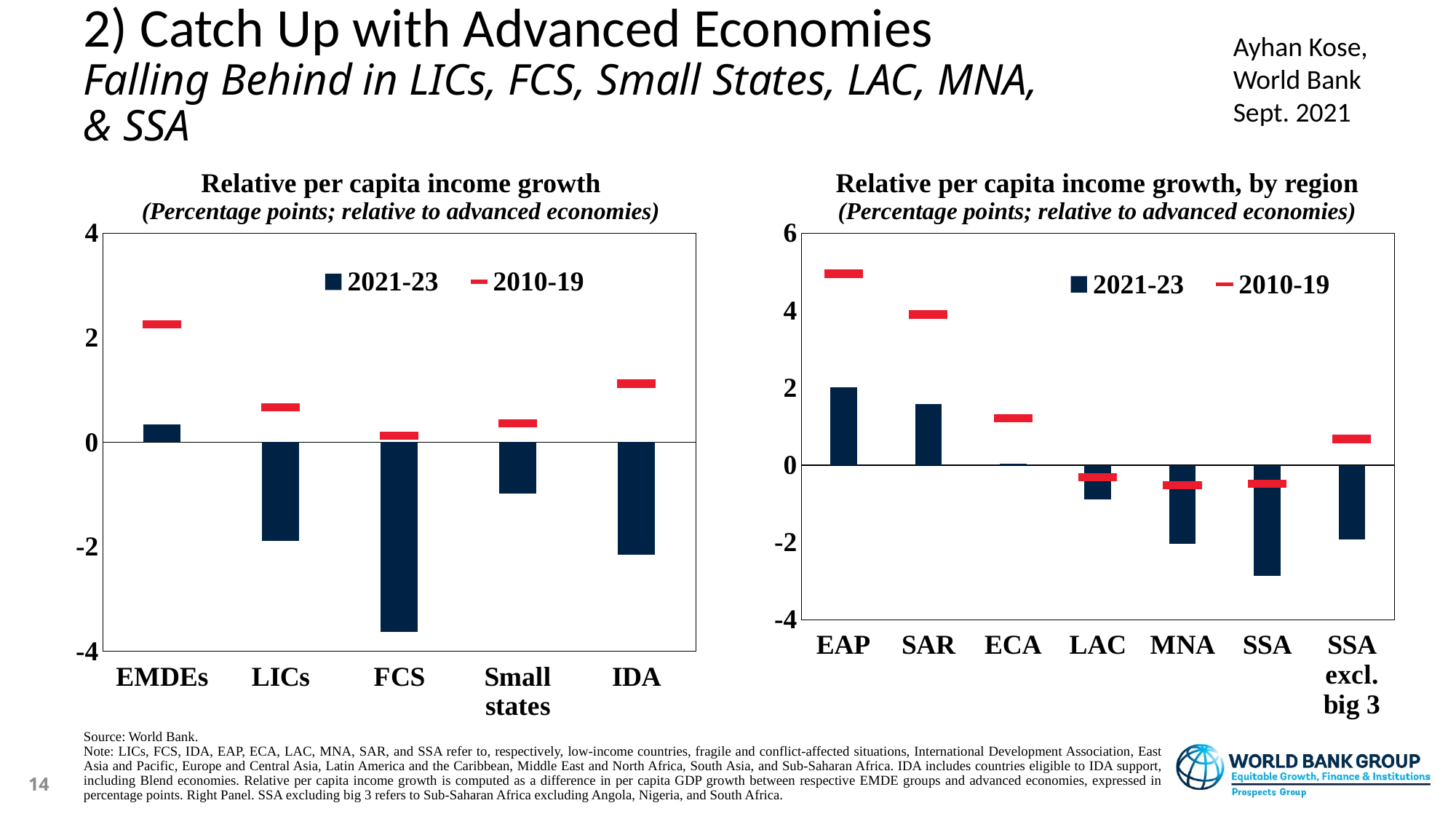
In the left chart, 'Relative per capita income growth', which category has the highest 2010-19 value? EMDEs How many series does the legend of the left chart, 'Relative per capita income growth', list? 2 In the left chart, 'Relative per capita income growth', which category has the highest 2021-23 value? EMDEs In the right chart, 'Relative per capita income growth, by region', which region has the lowest 2021-23 value? SSA In the left chart, 'Relative per capita income growth', is the 2021-23 value for FCS greater or less than -2? less In the left chart, 'Relative per capita income growth', which category has the lowest 2021-23 value? FCS What kind of chart is the left chart, 'Relative per capita income growth'? bar chart How many regions are shown on the x axis of the right chart, 'Relative per capita income growth, by region'? 7 In the right chart, 'Relative per capita income growth, by region', which region has the highest 2010-19 value? EAP In the right chart, 'Relative per capita income growth, by region', which has the larger 2021-23 value, EAP or SAR? EAP In the right chart, 'Relative per capita income growth, by region', is the 2010-19 value for EAP greater or less than 4? greater How many categories are shown on the x axis of the left chart, 'Relative per capita income growth'? 5